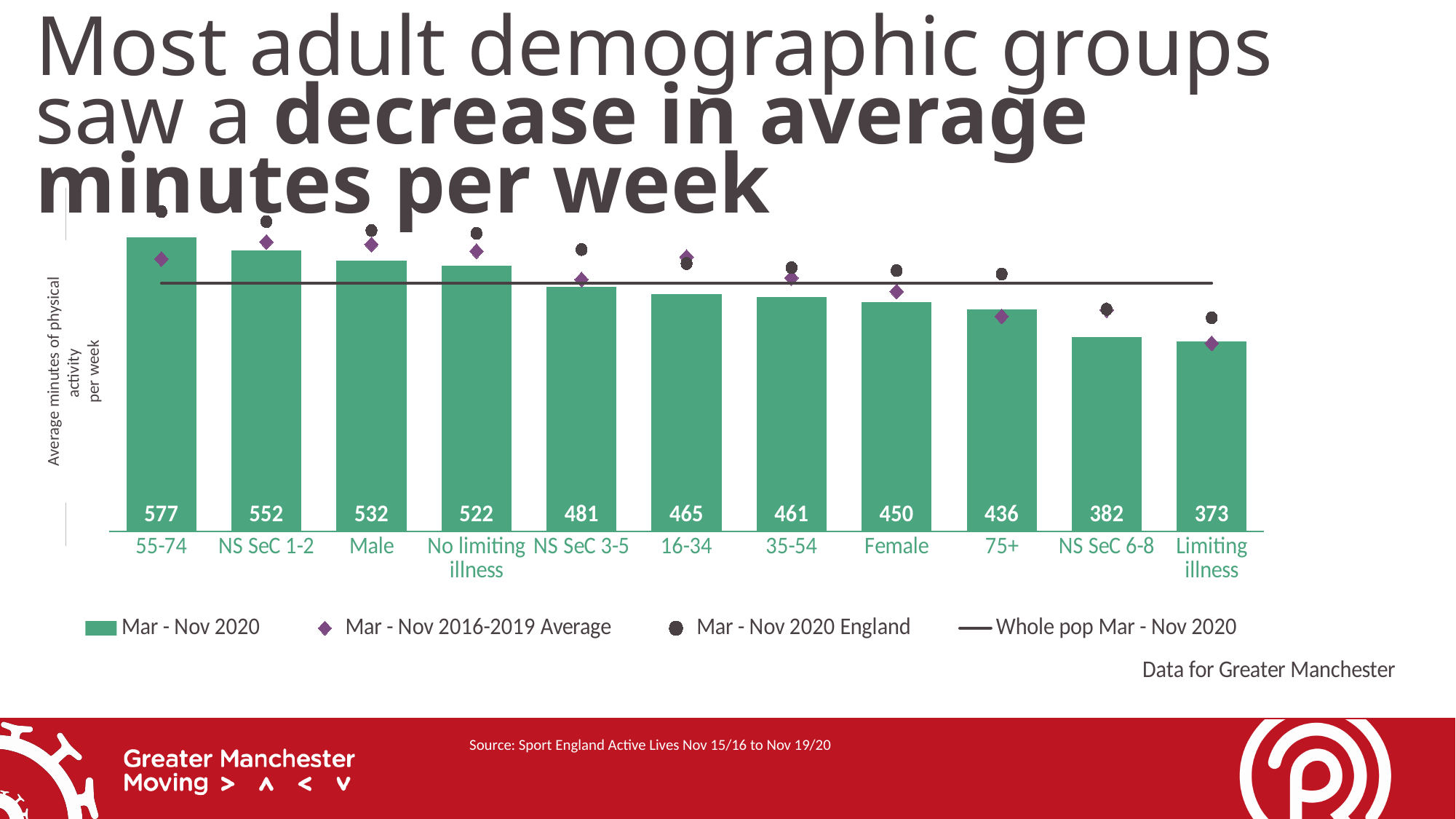
What is the difference between the Mar - Nov 2020 values for Male and Female? 82 Which has a larger Mar - Nov 2020 value, NS SeC 1-2 or NS SeC 3-5? NS SeC 1-2 Do the Mar - Nov 2020 bar values rise or fall from left to right along the x axis? Fall What is the difference between the Mar - Nov 2020 values for No limiting illness and Limiting illness? 149 How many demographic groups are shown on the x axis? 11 What is the Mar - Nov 2020 value for Female? 450 How many series does the legend list? 4 Which group has the highest Mar - Nov 2020 value? 55-74 What is the Mar - Nov 2020 value for NS SeC 6-8? 382 What is the Mar - Nov 2020 value for the 55-74 group? 577 What kind of chart is shown on the slide? Bar chart Which group has the lowest Mar - Nov 2020 value? Limiting illness